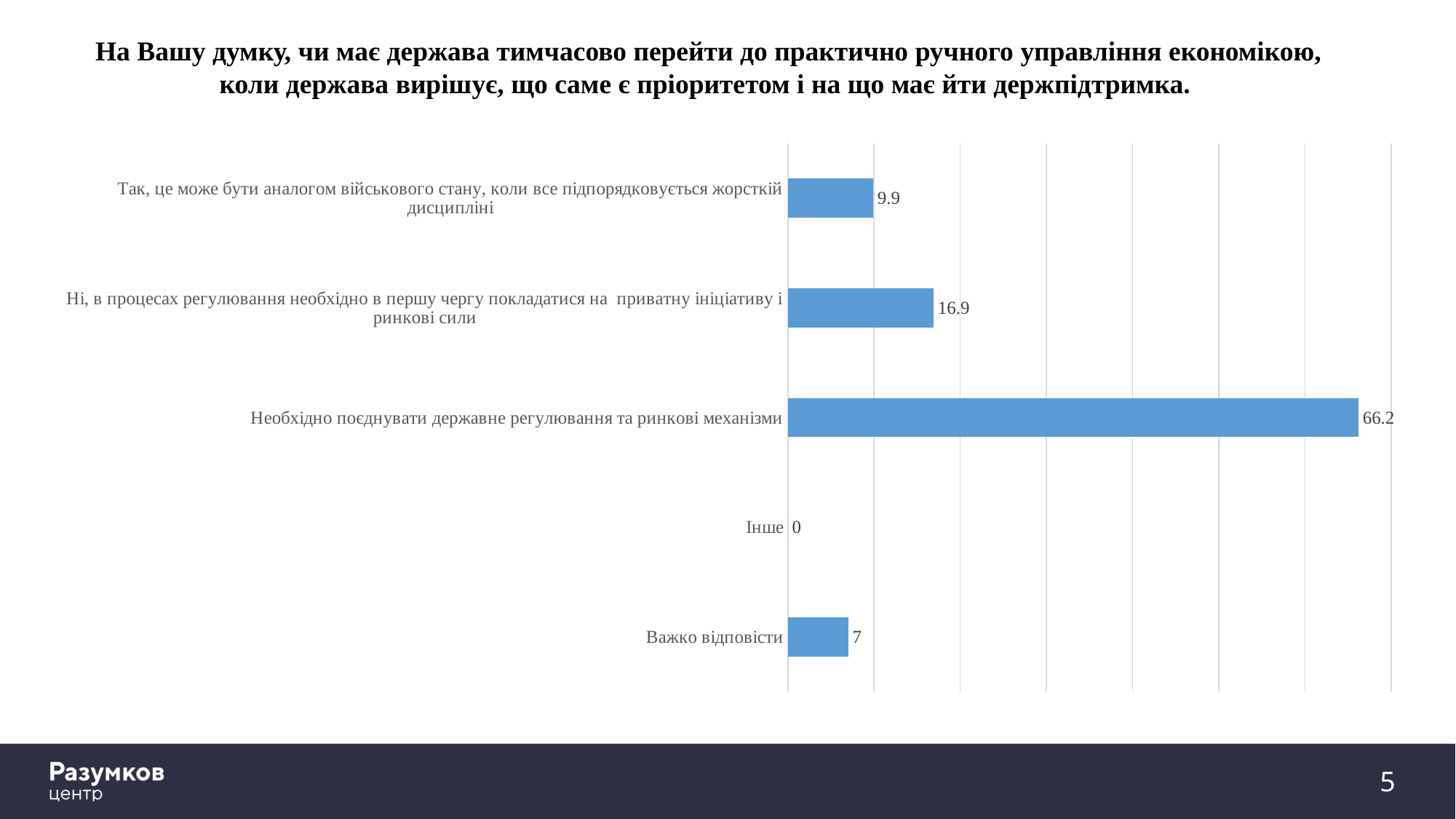
Which category has the highest value? Необхідно поєднувати державне регулювання та ринкові механізми What is the value for "Важко відповісти"? 7 What colour are the bars in the chart? Blue What is the value for "Необхідно поєднувати державне регулювання та ринкові механізми"? 66.2 How many categories are shown in the chart? 5 What kind of chart is shown on the slide? Bar chart What is the value for "Інше"? 0 What is the difference between the values for "Ні, в процесах регулювання необхідно в першу чергу покладатися на приватну ініціативу і ринкові сили" and "Так, це може бути аналогом військового стану, коли все підпорядковується жорсткій дисципліні"? 7 Which category has the lowest value? Інше What is the value for "Ні, в процесах регулювання необхідно в першу чергу покладатися на приватну ініціативу і ринкові сили"? 16.9 What is the value for "Так, це може бути аналогом військового стану, коли все підпорядковується жорсткій дисципліні"? 9.9 Which is larger: the value for "Важко відповісти" or the value for "Так, це може бути аналогом військового стану, коли все підпорядковується жорсткій дисципліні"? Так, це може бути аналогом військового стану, коли все підпорядковується жорсткій дисципліні